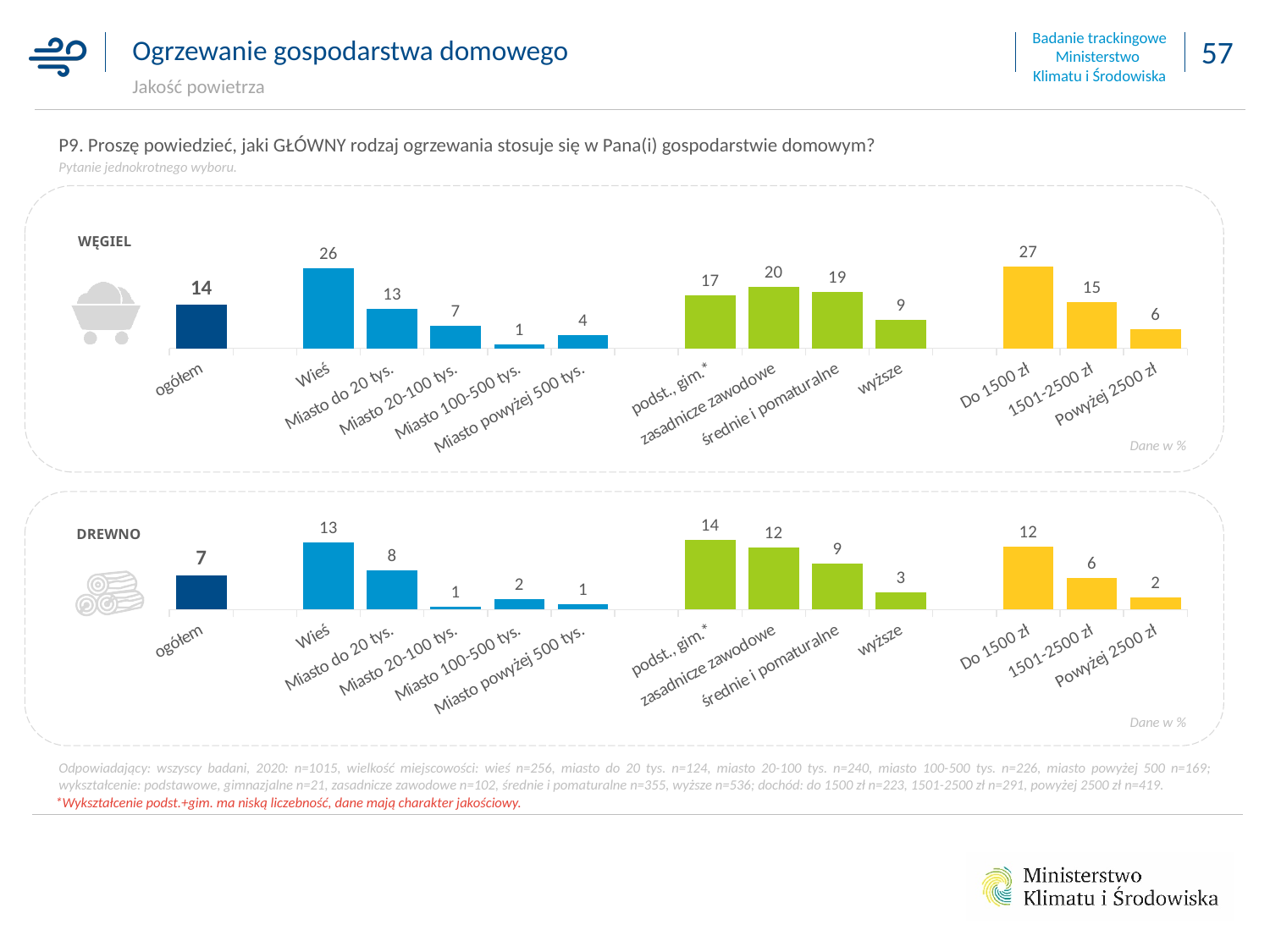
In the WĘGIEL chart, which is larger: the value for zasadnicze zawodowe or the value for wyższe? zasadnicze zawodowe In the DREWNO chart, what is the value for ogółem? 7 What type of chart is the WĘGIEL chart? Bar chart In the WĘGIEL chart, what is the value for Wieś? 26 In the DREWNO chart, which is larger: the value for Do 1500 zł or the value for 1501-2500 zł? Do 1500 zł In the WĘGIEL chart, what is the difference between the values for Do 1500 zł and Powyżej 2500 zł? 21 In the WĘGIEL chart, which category has the highest value? Do 1500 zł In the WĘGIEL chart, which category has the lowest value? Miasto 100-500 tys. How many categories are plotted in the DREWNO chart? 13 In the DREWNO chart, what is the difference between the values for Wieś and Miasto do 20 tys.? 5 In the DREWNO chart, what is the value for podst., gim.*? 14 In the WĘGIEL chart, what is the value for ogółem? 14